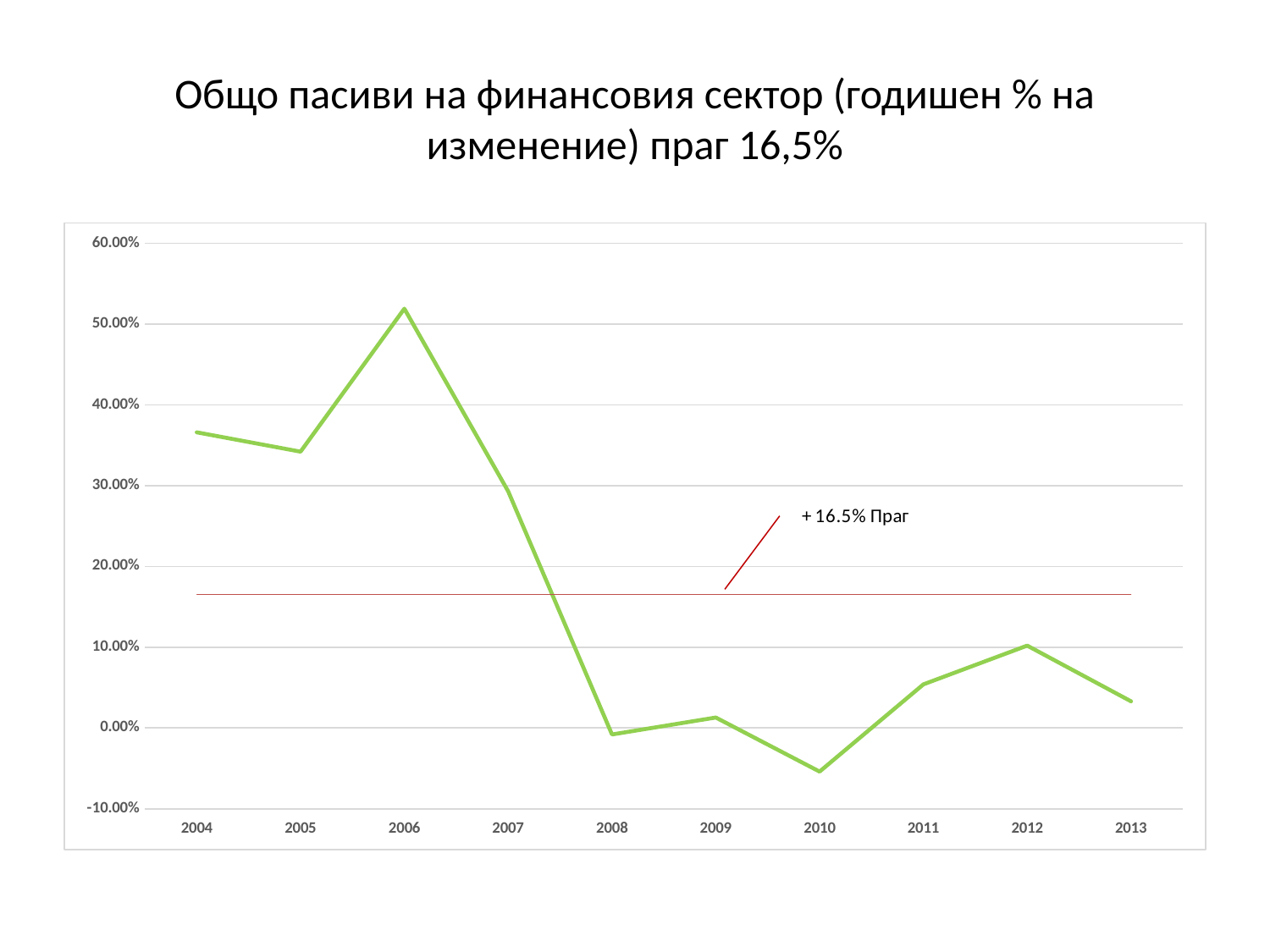
How many years are plotted on the x axis of the chart? 10 Is the value for 2006 greater or less than 40.00%? greater Which year has the larger value, 2011 or 2013? 2011 What threshold value is marked by the red horizontal line on the chart? 16.5% Is the value for 2011 greater or less than 10.00%? less In which year does the green line reach its highest value? 2006 What kind of chart is shown on the slide? line chart Is the value for 2010 greater or less than 0.00%? less Does the green line rise or fall between 2006 and 2010? fall In which year does the green line reach its lowest value? 2010 Which year has the larger value, 2006 or 2007? 2006